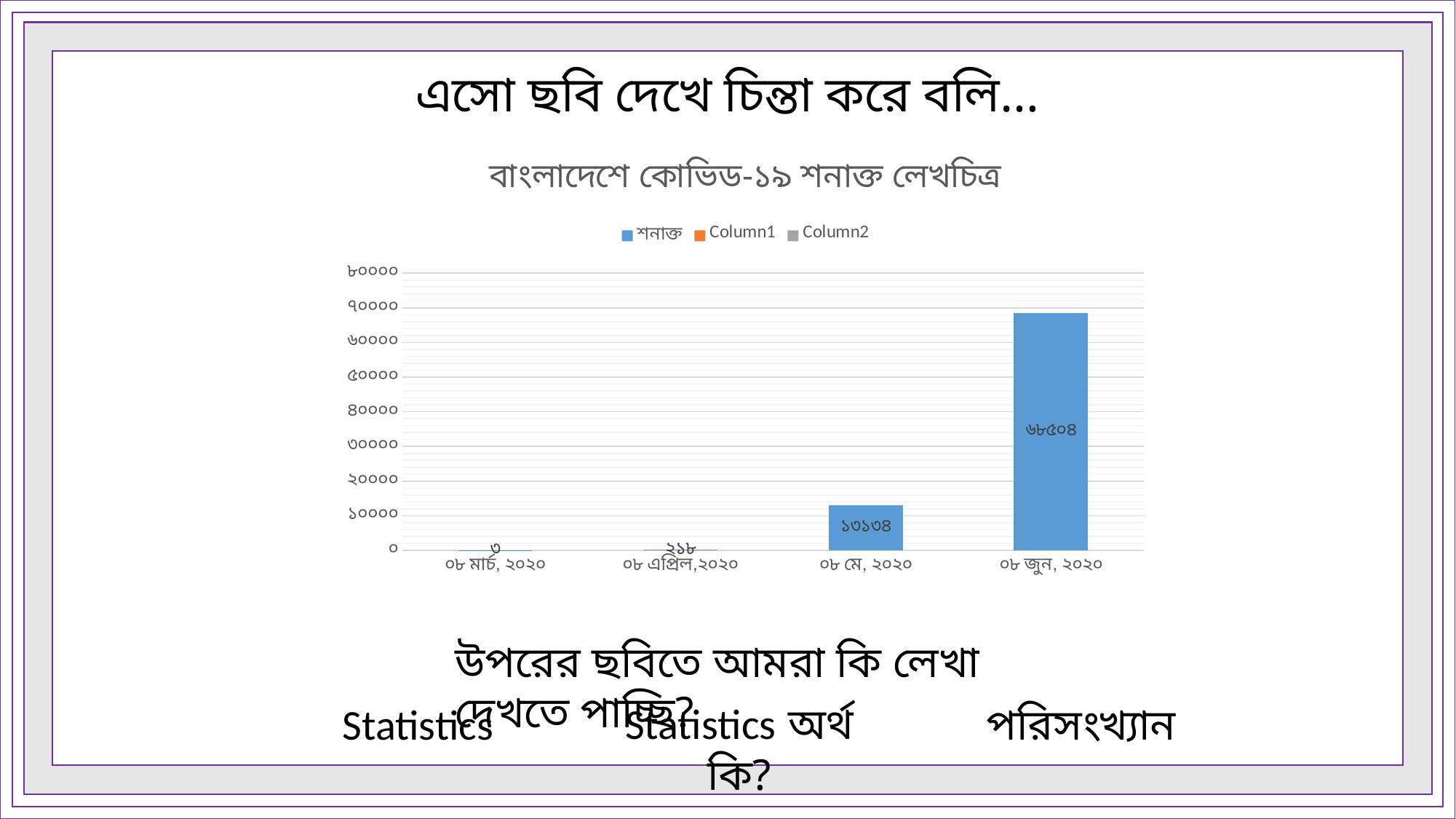
Which date has the lowest value? ০৮ মার্চ, ২০২০ Is the value for ০৮ জুন, ২০২০ greater or less than ৬০০০০? greater Which date has the highest value? ০৮ জুন, ২০২০ What is the difference between the values for ০৮ জুন, ২০২০ and ০৮ মে, ২০২০? ৫৫৩৭০ What type of chart is shown on the slide? bar chart What is the value for ০৮ মে, ২০২০? ১৩১৩৪ How many dates are shown on the x axis? 4 What is the value for ০৮ জুন, ২০২০? ৬৮৫০৪ What is the value for ০৮ এপ্রিল,২০২০? ২১৮ How many series does the legend list? 3 Which is larger, the value for ০৮ মে, ২০২০ or ০৮ এপ্রিল,২০২০? ০৮ মে, ২০২০ What is the value for ০৮ মার্চ, ২০২০? ৩